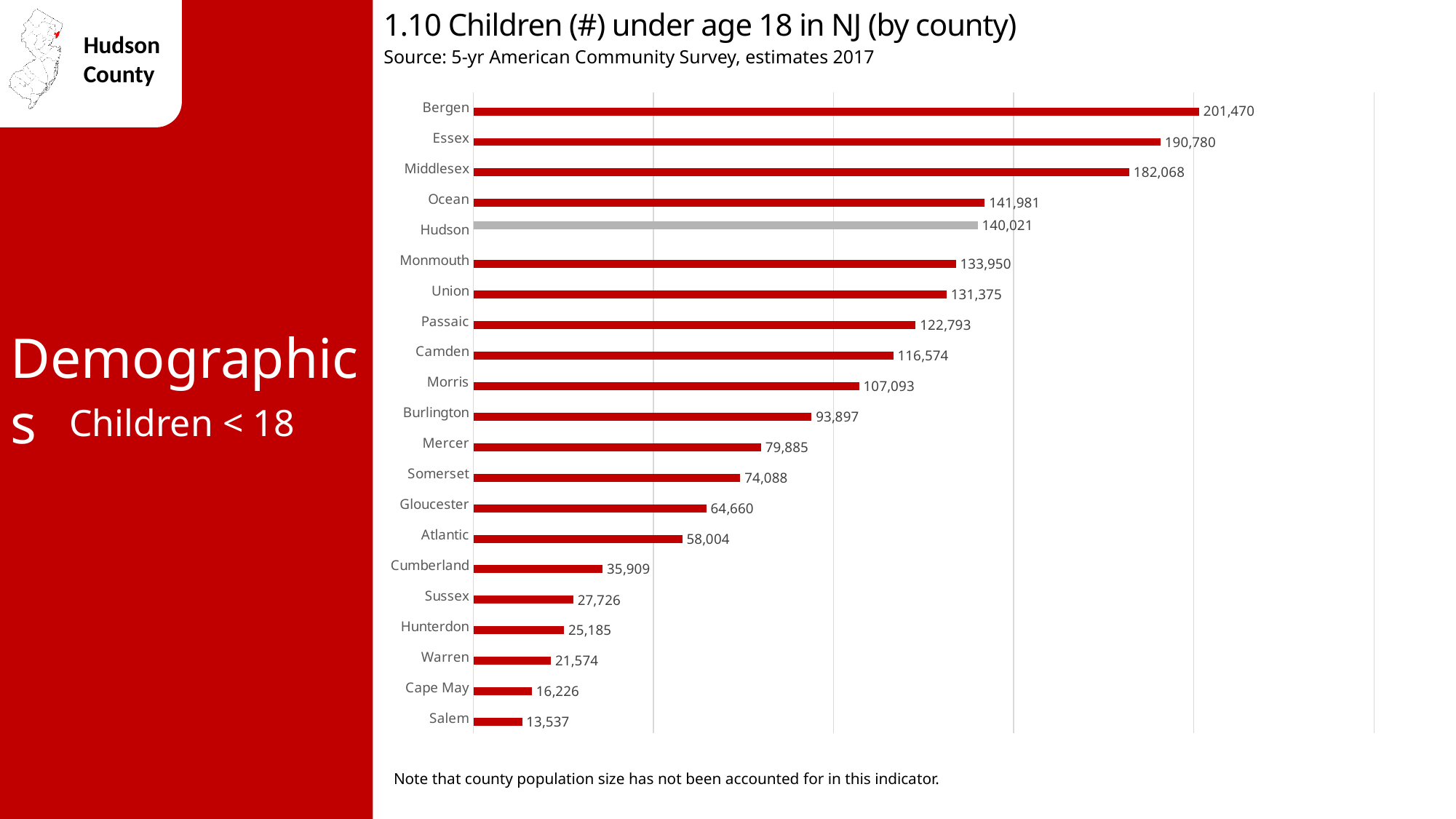
Which county has the lowest number of children under age 18? Salem What type of chart is shown on the slide? Bar chart Which county has the highest number of children under age 18? Bergen What is the value shown for Cumberland? 35,909 What is the value shown for Passaic? 122,793 Which county has more children under 18, Morris or Camden? Camden What is the difference between the values for Bergen and Essex? 10,690 Which county has more children under 18, Sussex or Warren? Sussex How many counties are shown in the chart? 21 Which county's bar is shown in grey rather than red? Hudson How many children under age 18 are there in Hudson County? 140,021 What is the difference between the values for Ocean and Hudson? 1,960